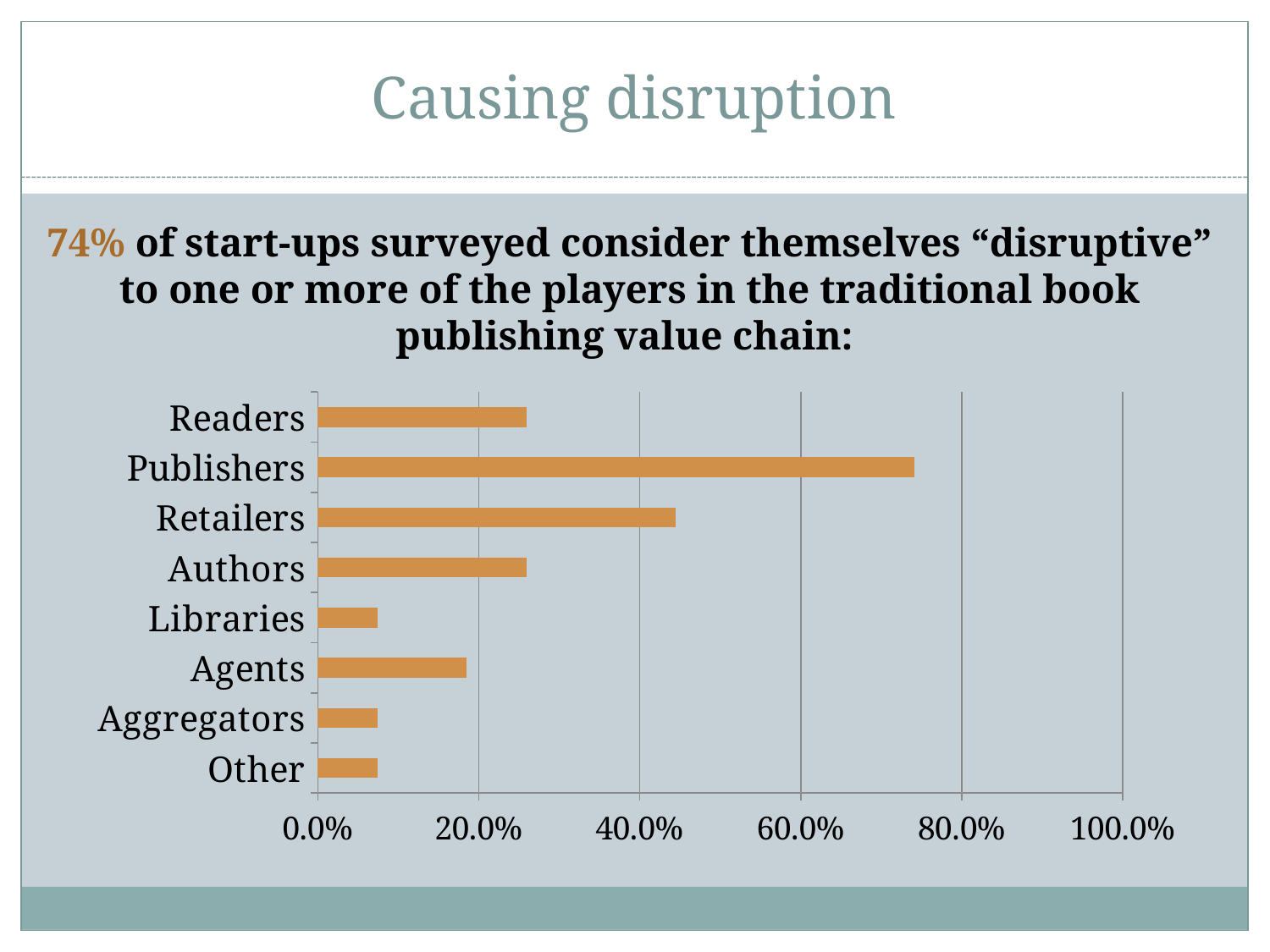
Which is larger, the value for Agents or the value for Aggregators? Agents Which category has the highest value in the chart? Publishers Which is larger, the value for Publishers or the value for Retailers? Publishers How many categories are plotted in the chart? 8 Is the value for Libraries greater or less than 20.0%? less Which is larger, the value for Retailers or the value for Authors? Retailers What is the highest value shown on the horizontal axis of the chart? 100.0% What kind of chart is shown on the slide? bar chart Is the value for Retailers greater or less than 40.0%? greater Is the value for Agents greater or less than 20.0%? less